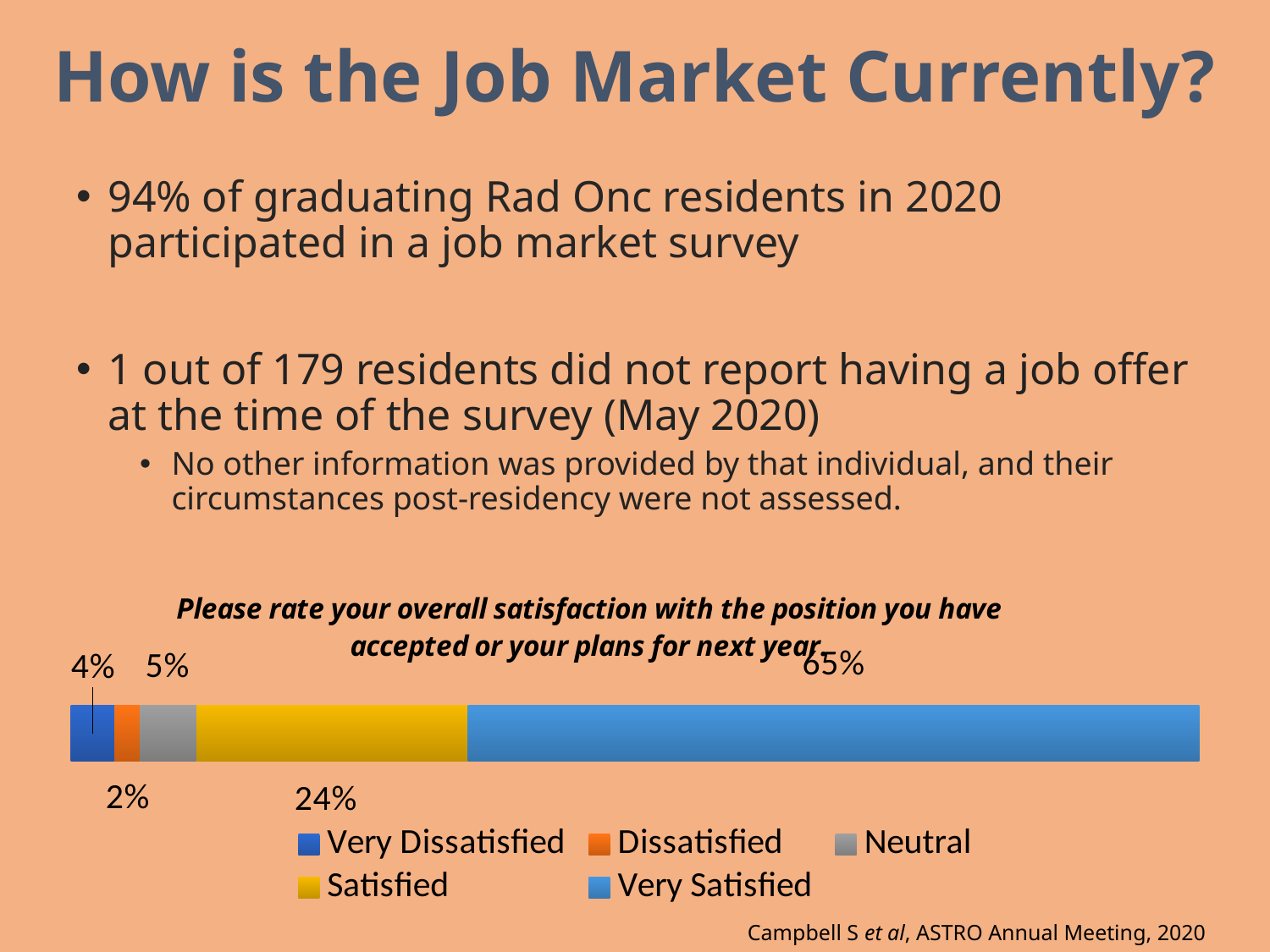
What percentage of respondents were Satisfied? 24% How many series does the legend list? 5 What is the difference in percentage points between Very Satisfied and Satisfied? 41 Which colour represents the Satisfied category in the chart? Yellow What is the combined percentage of Satisfied and Very Satisfied respondents? 89% Which satisfaction category has the smallest share of the bar? Dissatisfied What percentage of respondents were Neutral? 5% Which satisfaction category has the largest share of the bar? Very Satisfied What percentage of respondents were Very Satisfied? 65% What percentage of respondents were Very Dissatisfied? 4% What kind of chart is shown on the slide? Stacked bar chart Which is larger, the Neutral share or the Very Dissatisfied share? Neutral